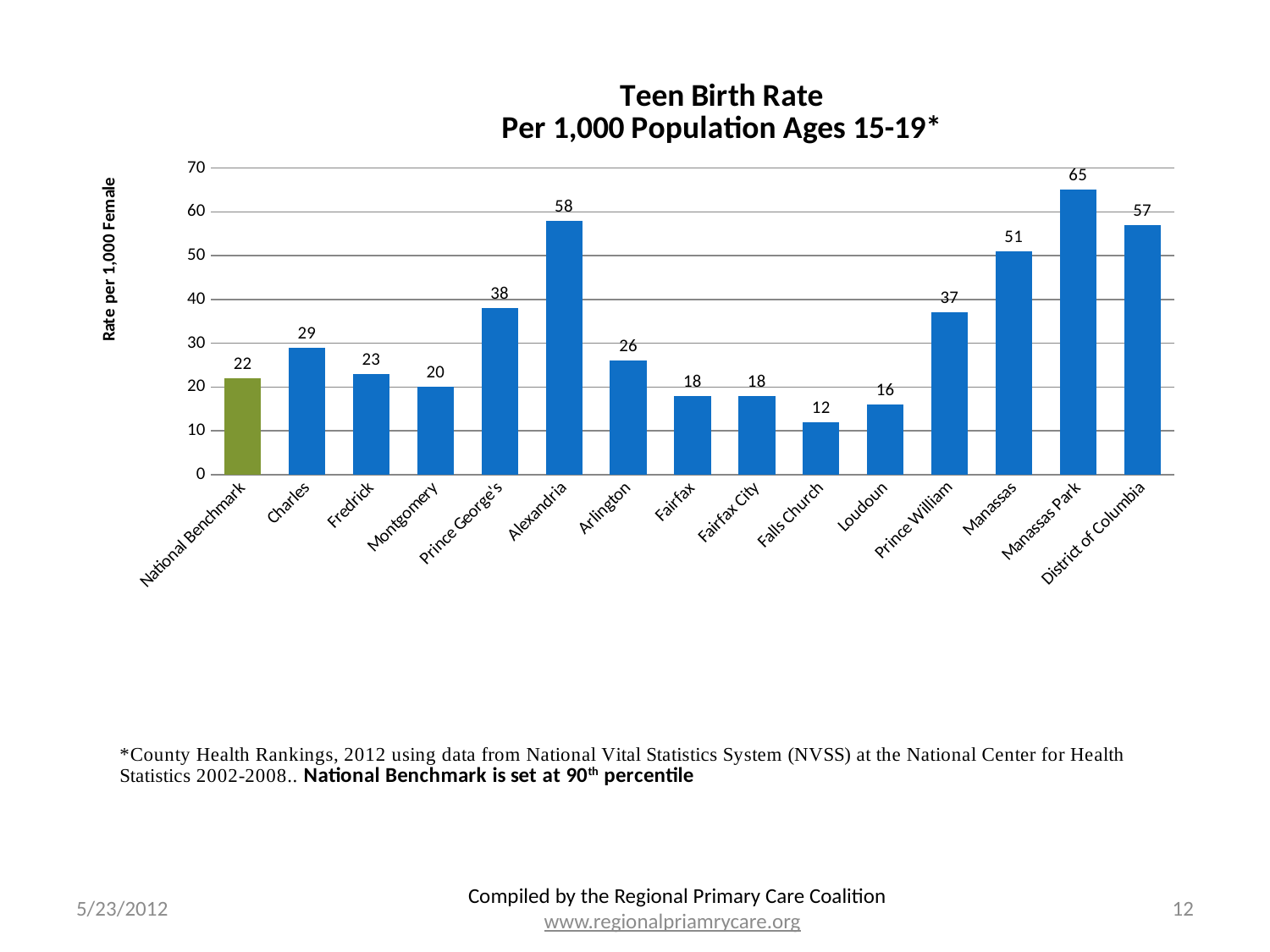
What is the teen birth rate for Alexandria? 58 What is the difference between the teen birth rates of Charles and Montgomery? 9 What is the title of the chart? Teen Birth Rate Per 1,000 Population Ages 15-19* How many categories are shown on the x axis? 15 What is the teen birth rate for Loudoun? 16 Which has a higher teen birth rate, Prince George's or Prince William? Prince George's What kind of chart is shown on the slide? Bar chart Which category has the highest teen birth rate? Manassas Park What is the difference between the teen birth rates of District of Columbia and Manassas? 6 Which bar is shown in a different colour (green) from the others? National Benchmark Which category has the lowest teen birth rate? Falls Church What is the value shown for the National Benchmark? 22